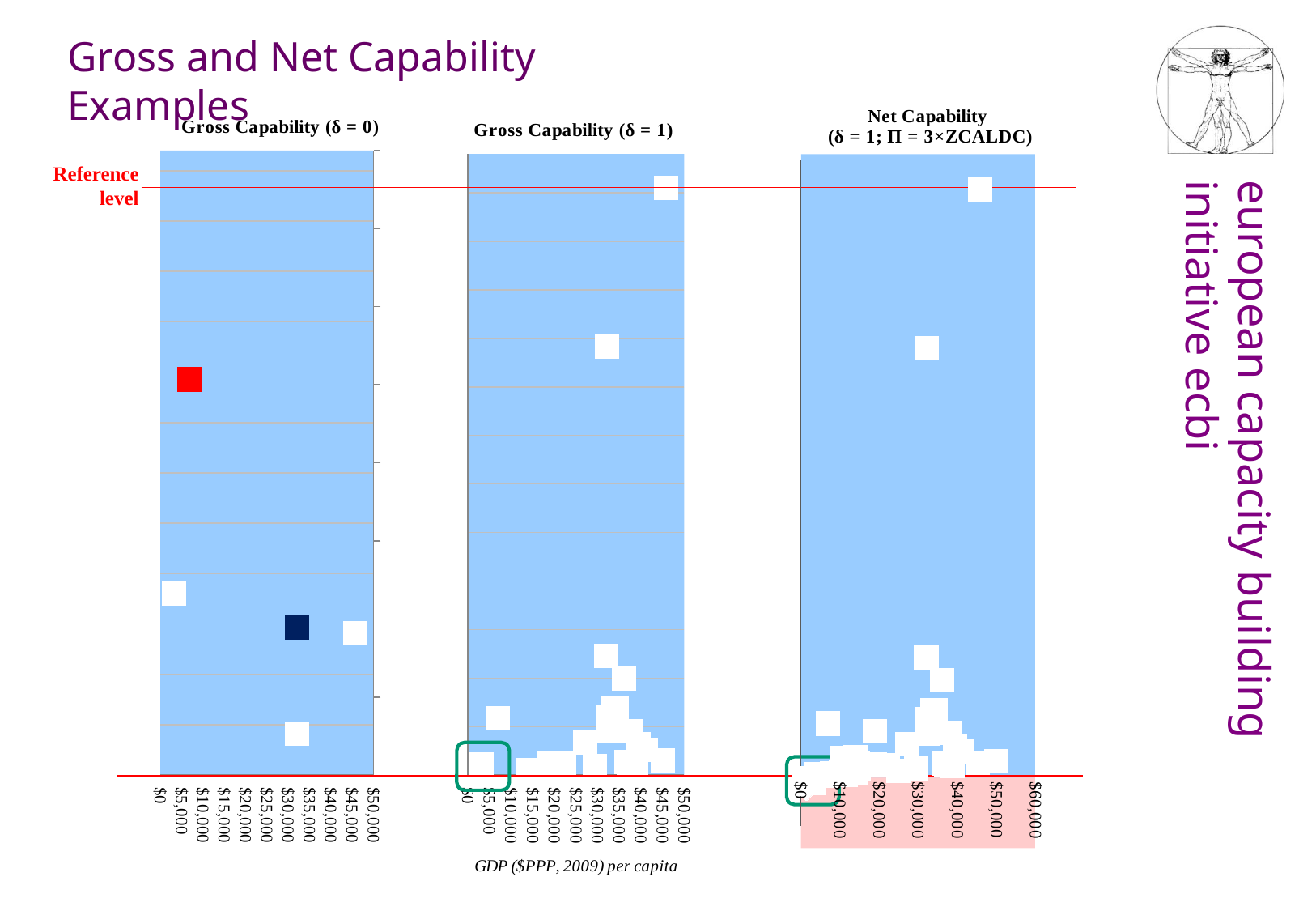
What is the x-axis label printed beneath the charts? GDP ($PPP, 2009) per capita What kind of chart is the middle chart, Gross Capability (δ = 1)? scatter chart In the rightmost chart, Net Capability, is the GDP per capita of the point closest to the reference level greater or less than $60,000? less In the leftmost chart, Gross Capability (δ = 0), is the GDP per capita of the red square greater or less than $10,000? less In the rightmost chart, Net Capability, is the GDP per capita of the point closest to the reference level greater or less than $40,000? greater What is the title of the leftmost chart? Gross Capability (δ = 0) How many charts are shown on the slide? 3 In the leftmost chart, Gross Capability (δ = 0), which point sits higher on the vertical axis, the red square or the dark blue square? the red square In the leftmost chart, Gross Capability (δ = 0), which point has the higher GDP per capita, the red square or the dark blue square? the dark blue square